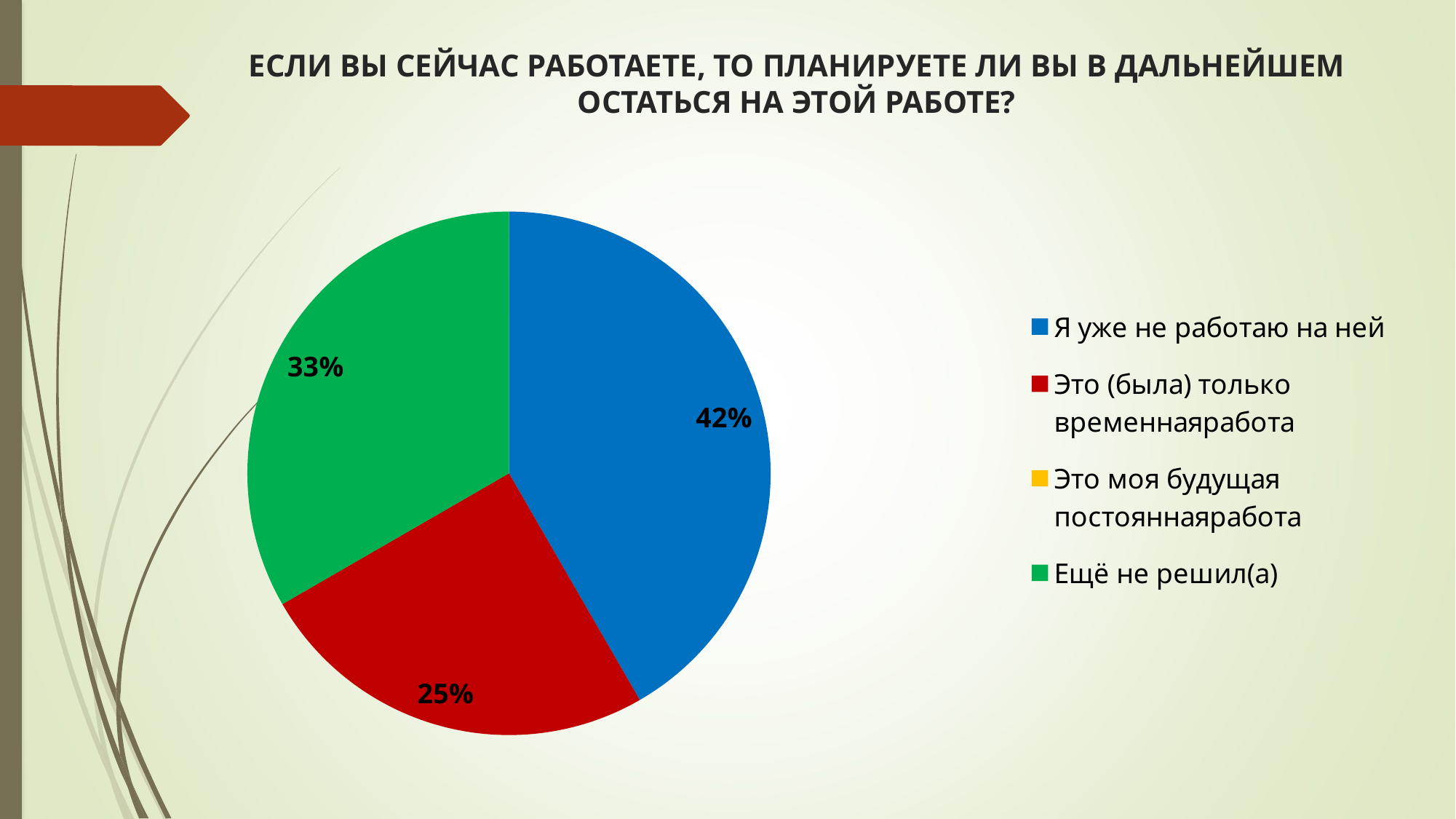
What is the difference in percentage points between the "Ещё не решил(а)" slice and the "Это (была) только временная работа" slice? 8 Which legend category is shown in blue? Я уже не работаю на ней Which is larger: the slice for "Ещё не решил(а)" or the slice for "Это (была) только временная работа"? Ещё не решил(а) What share of the pie is labelled for "Я уже не работаю на ней"? 42% What is the difference in percentage points between the "Я уже не работаю на ней" slice and the "Ещё не решил(а)" slice? 9 What share of the pie is labelled for "Ещё не решил(а)"? 33% What type of chart is shown on the slide? pie chart Which labelled slice of the pie is the smallest? Это (была) только временная работа What share of the pie is labelled for "Это (была) только временная работа"? 25% Which category has the largest slice of the pie? Я уже не работаю на ней What colour is the slice for "Ещё не решил(а)"? green How many categories does the legend list? 4